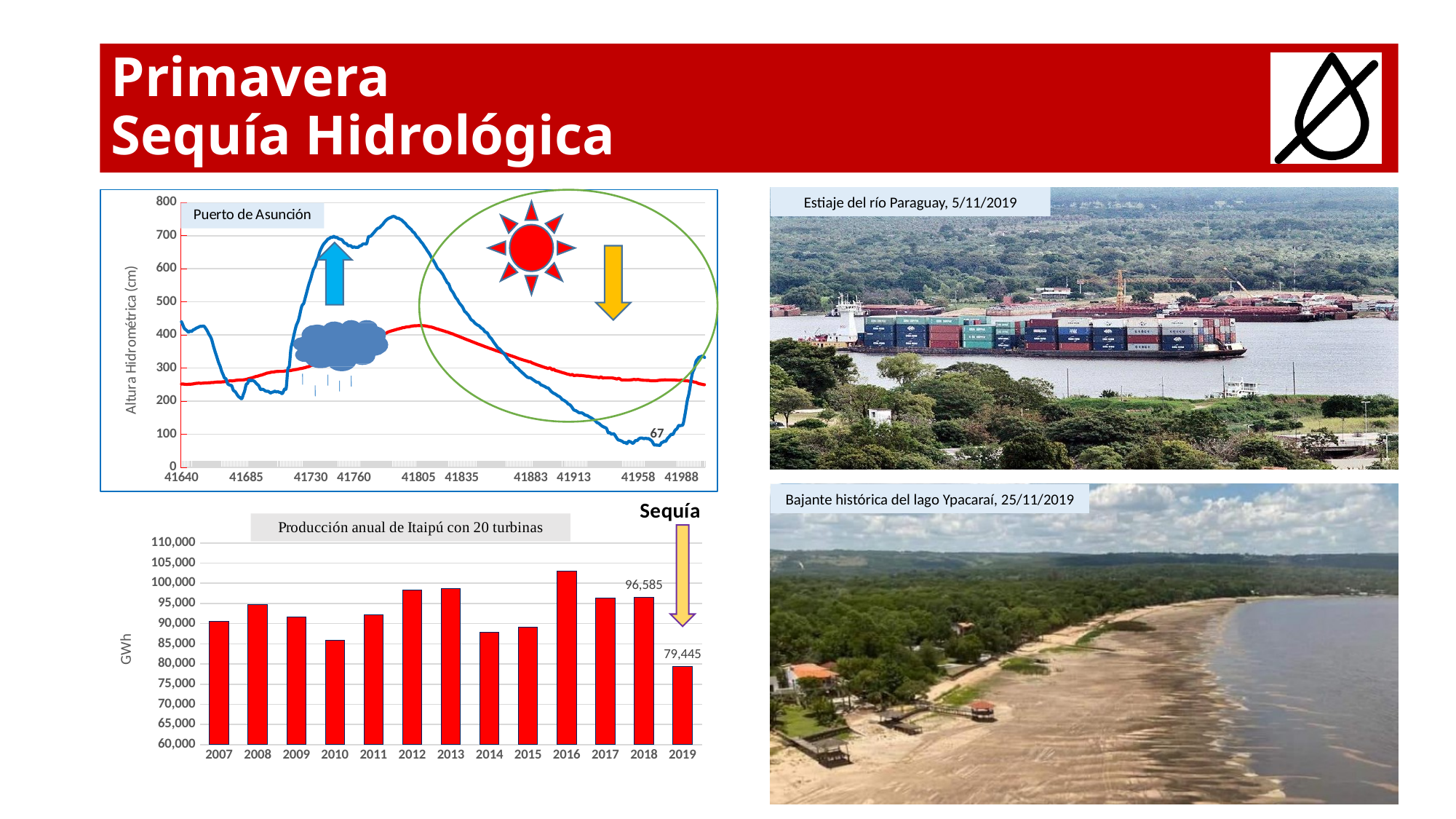
In the 'Producción anual de Itaipú con 20 turbinas' chart, is the value for 2016 greater or less than 100,000? greater In the 'Producción anual de Itaipú con 20 turbinas' chart, what is the value for 2019? 79,445 In the 'Producción anual de Itaipú con 20 turbinas' chart, what is the difference between the 2018 and 2019 values? 17,140 What kind of chart is the 'Producción anual de Itaipú con 20 turbinas' chart? bar chart In the 'Producción anual de Itaipú con 20 turbinas' chart, how many years are shown? 13 In the 'Producción anual de Itaipú con 20 turbinas' chart, which is larger, the value for 2012 or the value for 2014? 2012 In the 'Producción anual de Itaipú con 20 turbinas' chart, which year has the lowest production? 2019 What kind of chart is the 'Puerto de Asunción' chart? line chart In the 'Puerto de Asunción' chart, what is the labelled minimum value of the blue line? 67 In the 'Producción anual de Itaipú con 20 turbinas' chart, which year has the highest production? 2016 In the 'Producción anual de Itaipú con 20 turbinas' chart, is the value for 2010 greater or less than 90,000? less In the 'Producción anual de Itaipú con 20 turbinas' chart, what is the value for 2018? 96,585